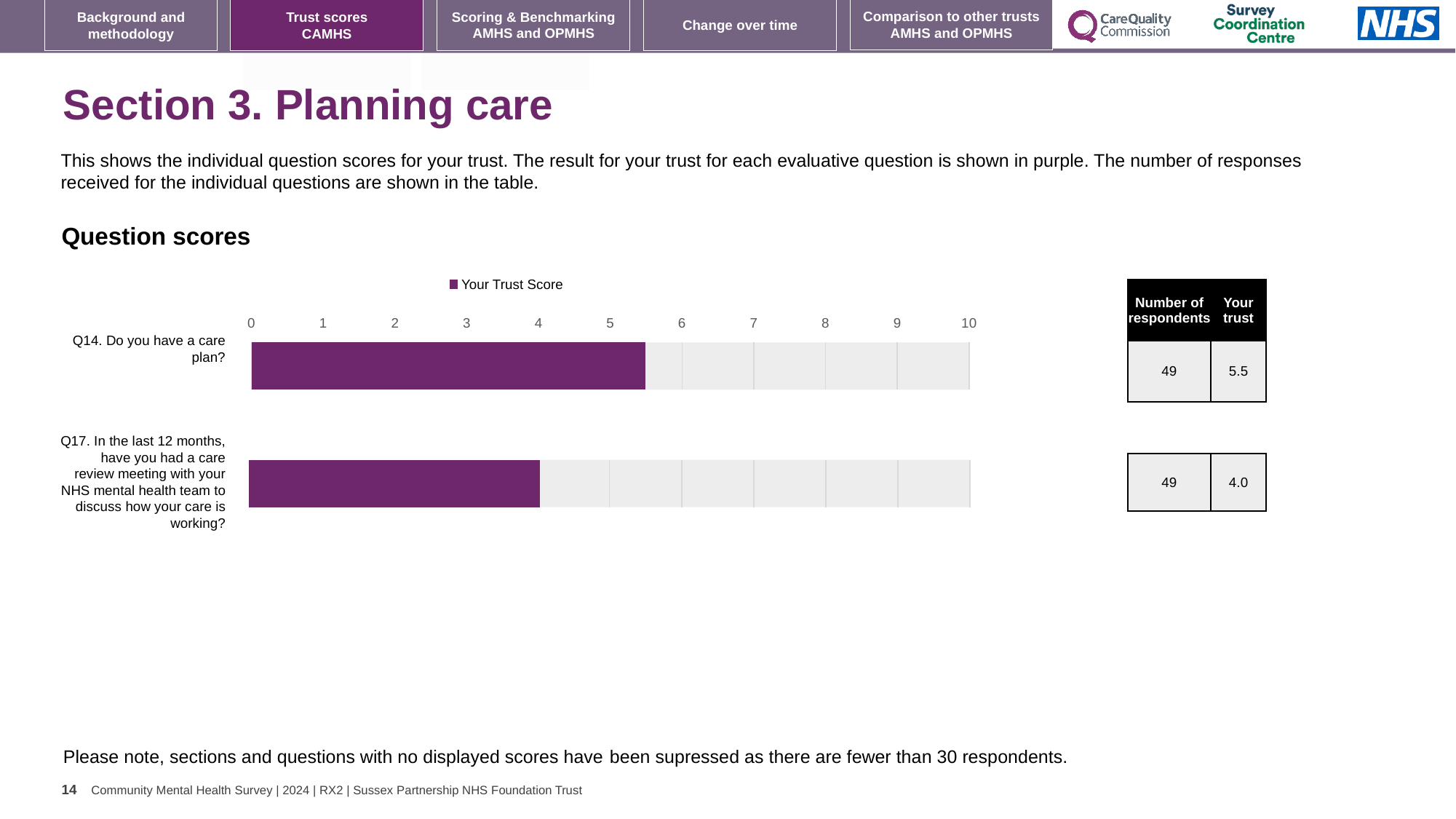
What is the difference between the trust scores for Q14 and Q17? 1.5 Is the trust score for Q14 greater or less than 5? greater Is the trust score for Q17 greater or less than 5? less How many series does the legend of the Question scores chart list? 1 What is the name of the series shown in the legend of the Question scores chart? Your Trust Score What type of chart is shown under "Question scores"? bar chart What is the trust score for Q14 "Do you have a care plan?"? 5.5 What is the trust score for Q17 about having a care review meeting in the last 12 months? 4.0 What is the maximum value shown on the x axis of the Question scores chart? 10 Which question has the lowest trust score in the Question scores chart? Q17. In the last 12 months, have you had a care review meeting with your NHS mental health team to discuss how your care is working? How many questions (bars) are plotted in the Question scores chart? 2 Which question has the highest trust score in the Question scores chart? Q14. Do you have a care plan?